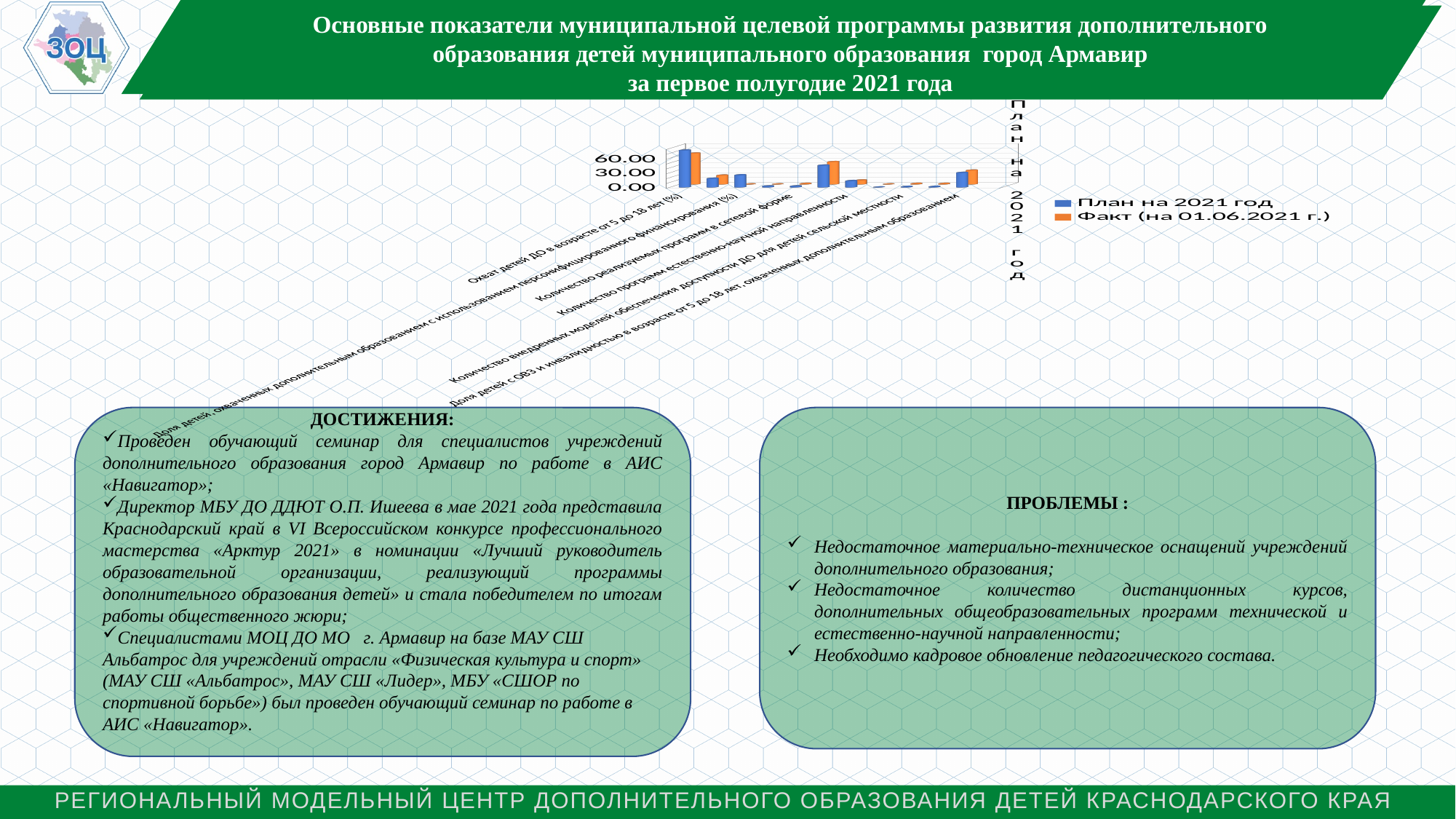
Is the "План на 2021 год" value for "Охват детей ДО в возрасте от 5 до 18 лет (%)" greater or less than 30.00? greater Is the "План на 2021 год" value for "Охват детей ДО в возрасте от 5 до 18 лет (%)" greater or less than 60.00? greater Is the "Факт (на 01.06.2021 г.)" value for "Количество реализуемых программ в сетевой форме" greater or less than 30.00? less What kind of chart is shown on the slide? bar chart How many series does the chart legend list? 2 What are the two series named in the chart legend? План на 2021 год; Факт (на 01.06.2021 г.) What is the highest value shown on the chart's vertical axis? 60.00 Which category has the highest value for "План на 2021 год"? Охват детей ДО в возрасте от 5 до 18 лет (%) Which colour represents the series "План на 2021 год" in the chart? blue